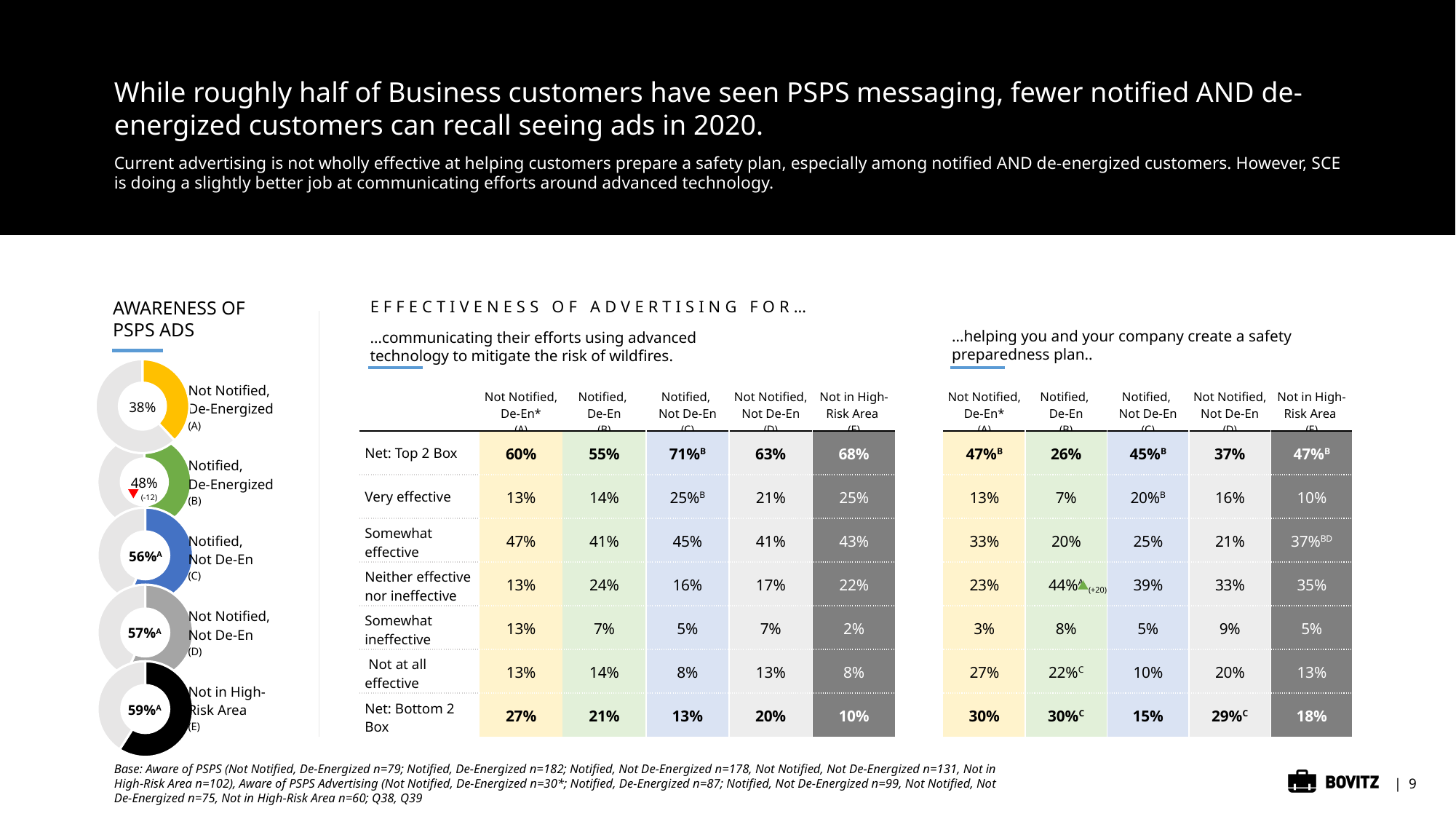
In the Awareness of PSPS Ads donut charts, what is the awareness value for Notified, Not De-En (C)? 56% How many donut charts are shown under Awareness of PSPS Ads? 5 What kind of chart is used to show Awareness of PSPS Ads? Donut (pie) chart In the Awareness of PSPS Ads donut charts, what is the awareness value for Not Notified, De-Energized (A)? 38% In the Awareness of PSPS Ads donut charts, what colour is the filled segment for Not Notified, De-Energized (A)? Yellow In the Awareness of PSPS Ads donut charts, what change is indicated next to the 48% value for Notified, De-Energized (B)? -12 In the Awareness of PSPS Ads donut charts, what is the difference between the awareness for Not in High-Risk Area (E) and Not Notified, De-Energized (A)? 21 percentage points In the Awareness of PSPS Ads donut charts, which group has the lowest awareness? Not Notified, De-Energized (A) In the Awareness of PSPS Ads donut charts, what is the awareness value for Not in High-Risk Area (E)? 59% In the Awareness of PSPS Ads donut charts, which group has the highest awareness? Not in High-Risk Area (E) In the Awareness of PSPS Ads donut charts, which is larger: awareness for Notified, De-Energized (B) or Not Notified, Not De-En (D)? Not Notified, Not De-En (D) In the Awareness of PSPS Ads donut charts, is the awareness for Not Notified, Not De-En (D) greater or less than 50%? greater